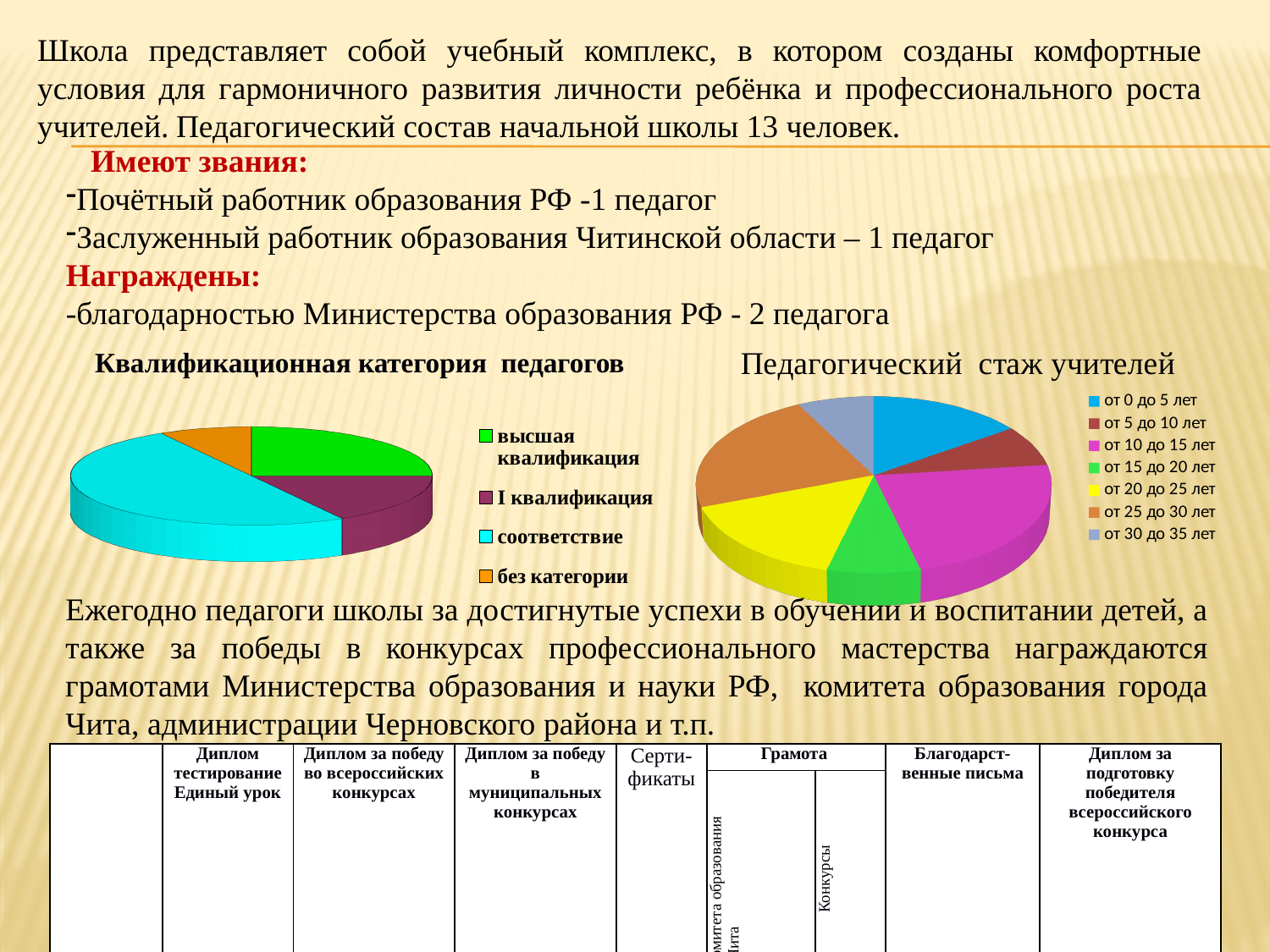
In the chart "Квалификационная категория педагогов", what colour is the slice for "соответствие"? cyan What kind of chart is the chart titled "Квалификационная категория педагогов"? pie chart In the chart "Педагогический стаж учителей", which slice is larger: "от 10 до 15 лет" or "от 5 до 10 лет"? от 10 до 15 лет What kind of chart is the chart titled "Педагогический стаж учителей"? pie chart In the chart "Квалификационная категория педагогов", which category has the largest slice? соответствие In the chart "Педагогический стаж учителей", what colour is the slice for "от 0 до 5 лет"? blue In the chart "Квалификационная категория педагогов", which category has the smallest slice? без категории How many categories does the legend of the chart "Педагогический стаж учителей" list? 7 In the chart "Квалификационная категория педагогов", which slice is larger: "I квалификация" or "без категории"? I квалификация In the chart "Педагогический стаж учителей", which slice is larger: "от 20 до 25 лет" or "от 30 до 35 лет"? от 20 до 25 лет How many categories does the legend of the chart "Квалификационная категория педагогов" list? 4